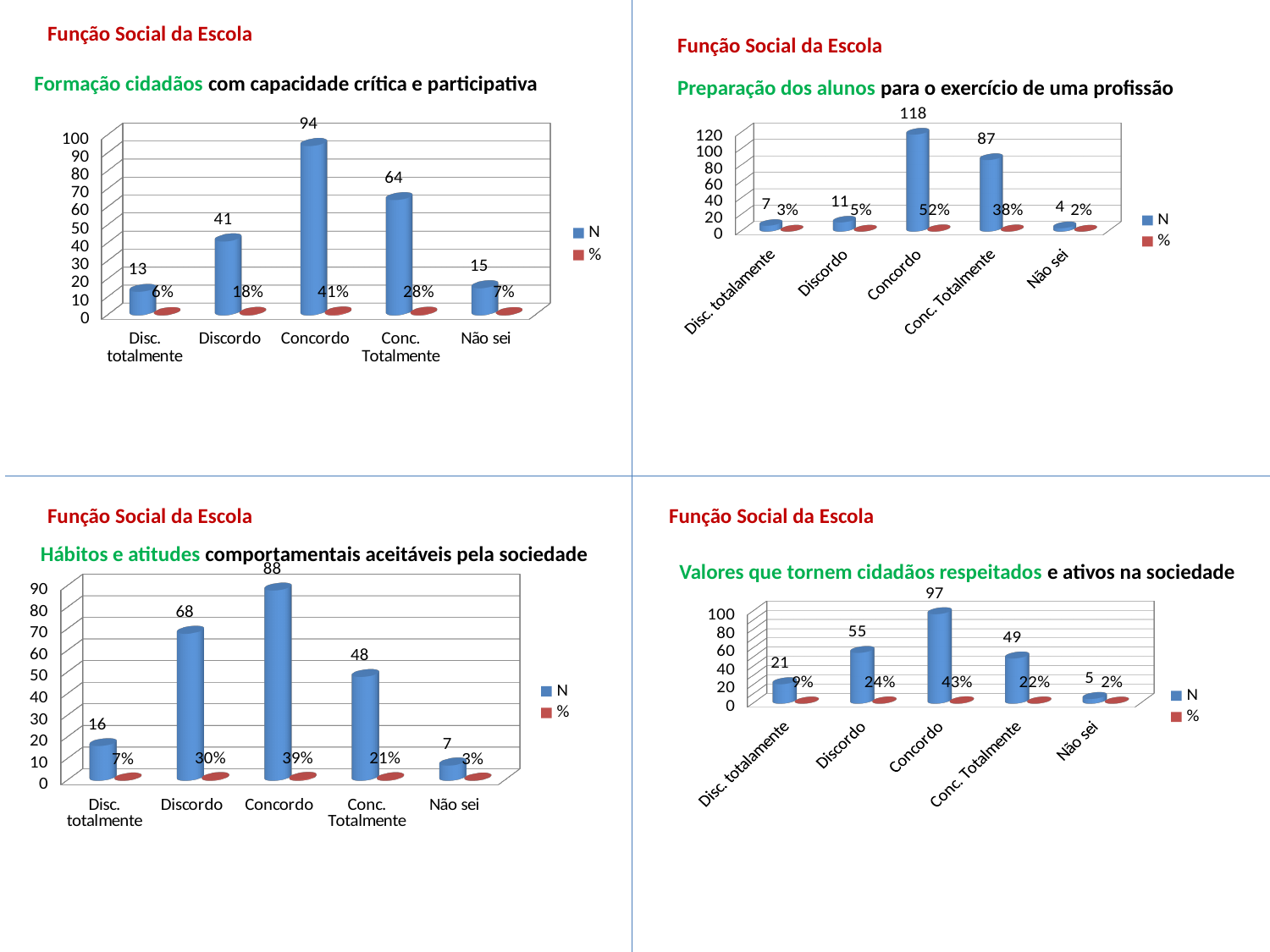
What kind of chart is the chart titled 'Valores que tornem cidadãos respeitados e ativos na sociedade'? Bar chart In the chart titled 'Preparação dos alunos para o exercício de uma profissão', which category has the highest N value? Concordo In the chart titled 'Hábitos e atitudes comportamentais aceitáveis pela sociedade', what is the difference between the N values for Concordo and Discordo? 20 In the chart titled 'Preparação dos alunos para o exercício de uma profissão', which category has the lowest N value? Não sei In the chart titled 'Hábitos e atitudes comportamentais aceitáveis pela sociedade', what percentage is shown for Discordo? 30% How many categories are shown on the x axis of the chart titled 'Hábitos e atitudes comportamentais aceitáveis pela sociedade'? 5 In the chart titled 'Formação cidadãos com capacidade crítica e participativa', what percentage is shown for Conc. Totalmente? 28% In the chart titled 'Preparação dos alunos para o exercício de uma profissão', what is the N value for Conc. Totalmente? 87 How many series does the legend list in the chart titled 'Formação cidadãos com capacidade crítica e participativa'? 2 In the chart titled 'Formação cidadãos com capacidade crítica e participativa', what is the N value for Concordo? 94 In the chart titled 'Valores que tornem cidadãos respeitados e ativos na sociedade', what is the N value for Disc. totalmente? 21 In the chart titled 'Valores que tornem cidadãos respeitados e ativos na sociedade', which is larger, the N value for Discordo or for Conc. Totalmente? Discordo